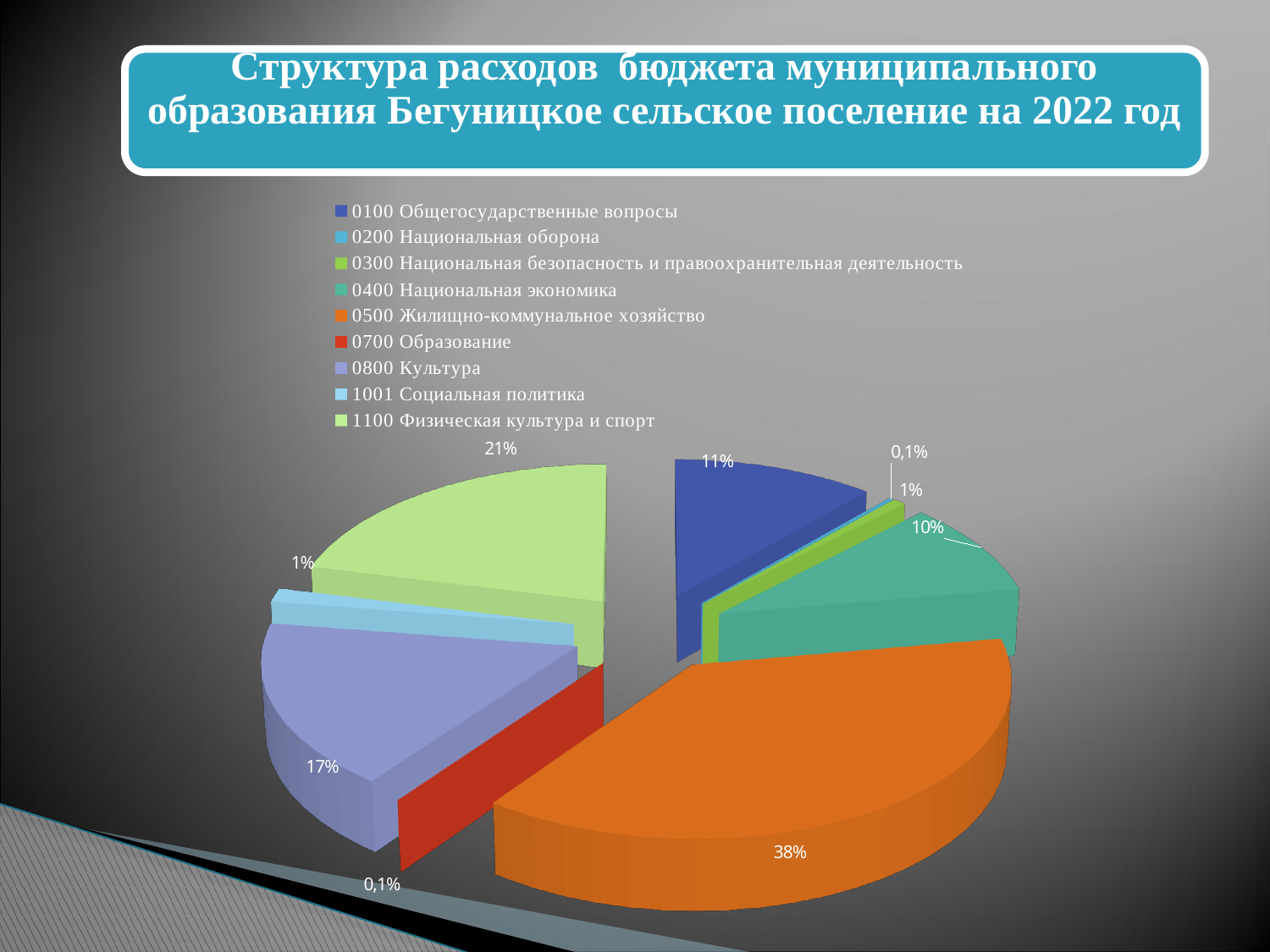
How many categories does the legend of the pie chart list? 9 What share of the budget expenditure goes to 0800 Культура? 17% Which category has the largest share of the budget expenditure? 0500 Жилищно-коммунальное хозяйство What share of the budget expenditure goes to 1100 Физическая культура и спорт? 21% Which is larger: the share for 0800 Культура or the share for 1100 Физическая культура и спорт? 1100 Физическая культура и спорт What share of the budget expenditure goes to 0100 Общегосударственные вопросы? 11% What kind of chart is shown on the slide? pie chart What is the title of the slide containing the pie chart? Структура расходов бюджета муниципального образования Бегуницкое сельское поселение на 2022 год What is the difference between the share for 0500 Жилищно-коммунальное хозяйство and the share for 1100 Физическая культура и спорт? 17%